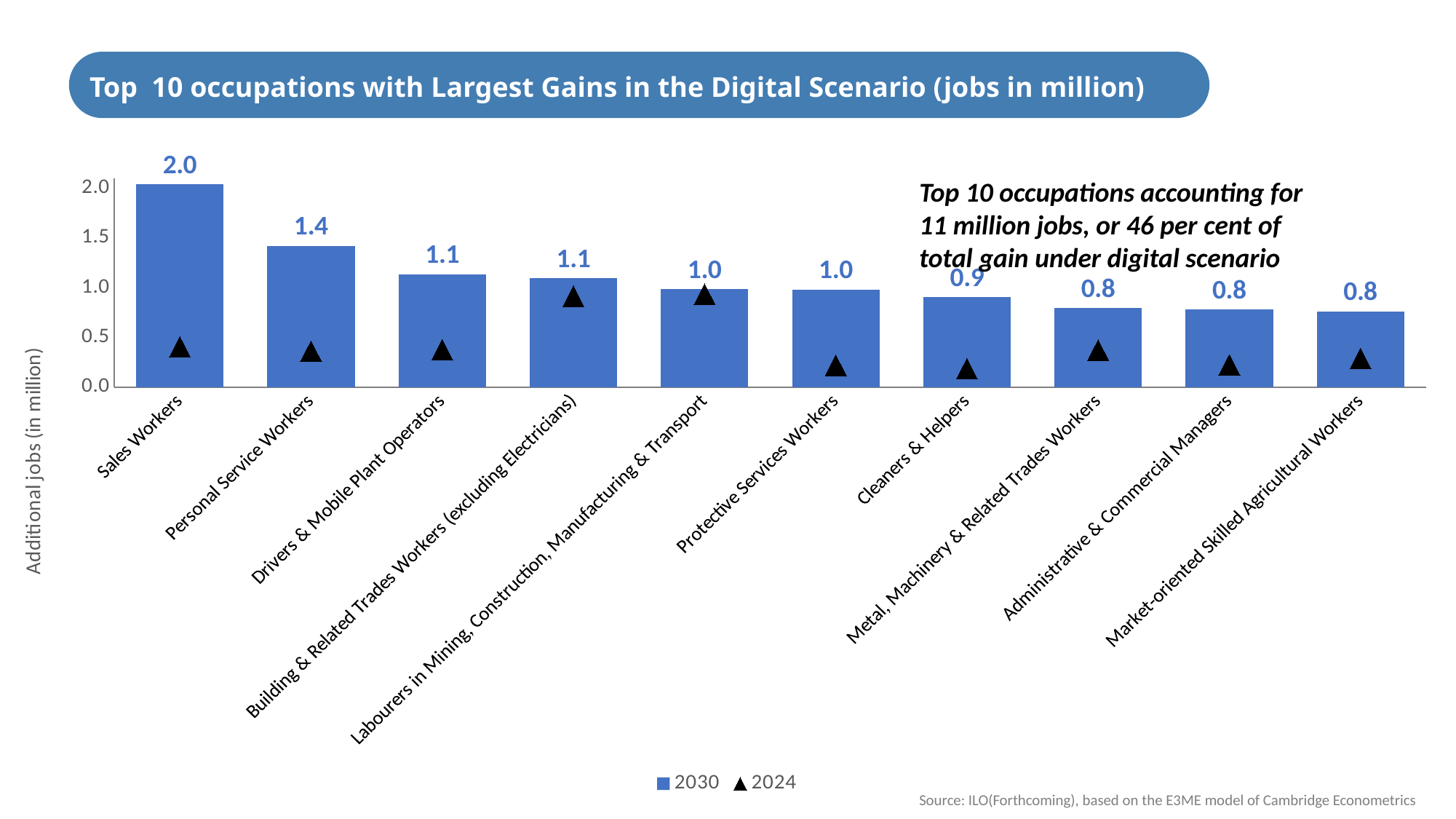
What is the 2030 value for Administrative & Commercial Managers? 0.8 What is the 2030 value for Cleaners & Helpers? 0.9 How many series does the legend list? 2 What is the 2030 value for Sales Workers? 2.0 Is the 2024 value for Protective Services Workers greater or less than 0.5? less Do the 2030 values rise or fall from left to right across the chart? fall Which occupation has the highest 2030 value? Sales Workers Is the 2024 value for Building & Related Trades Workers (excluding Electricians) greater or less than 0.5? greater What is the difference between the 2030 values for Sales Workers and Personal Service Workers? 0.6 What is the 2030 value for Personal Service Workers? 1.4 How many occupations are shown on the chart? 10 Which has a larger 2030 value, Personal Service Workers or Protective Services Workers? Personal Service Workers